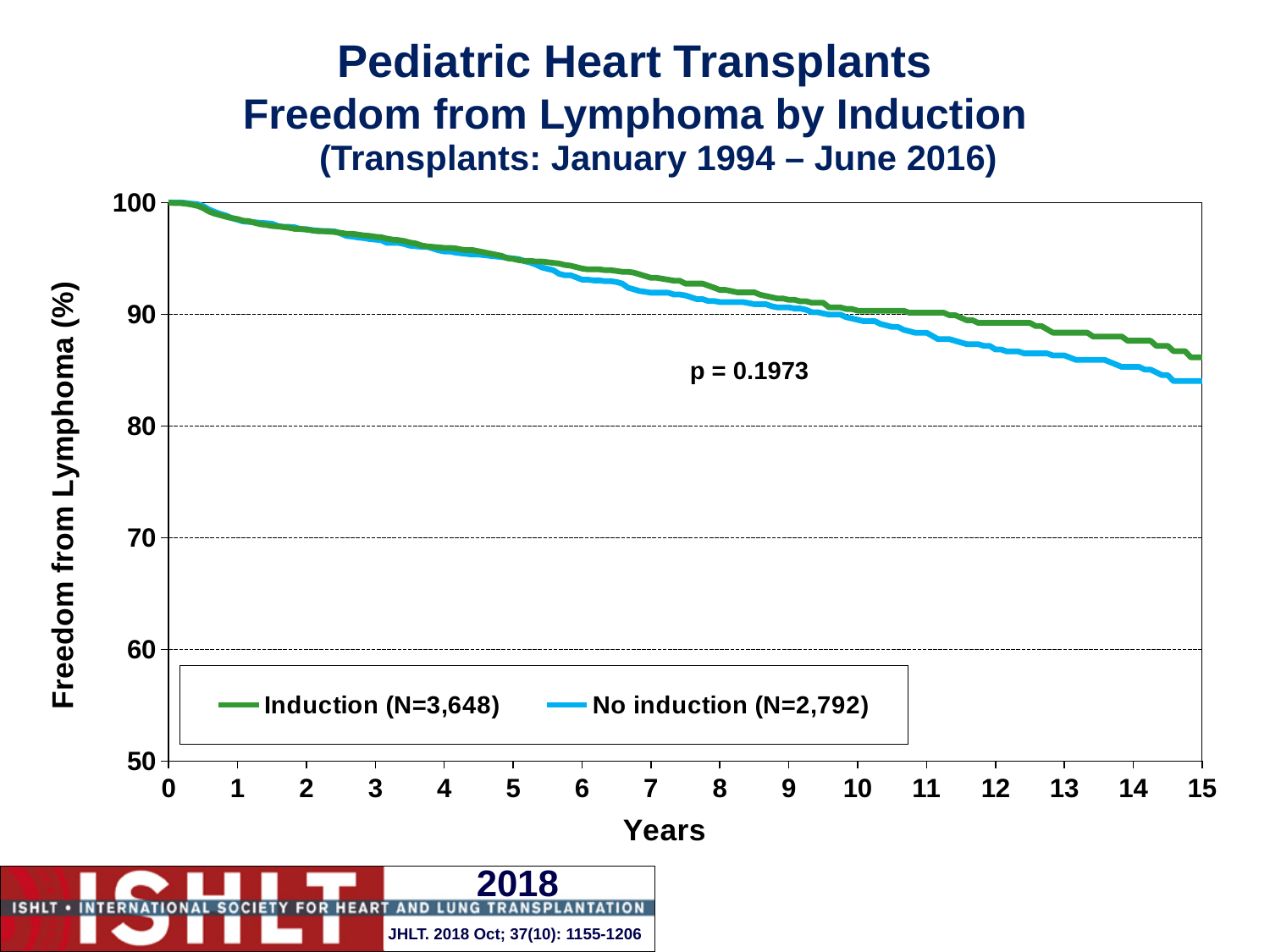
How many series does the legend list? 2 At 15 years, which series has the higher freedom from lymphoma: Induction or No induction? Induction What kind of chart is shown on the slide? Line chart Is the value for the No induction series at 15 years greater or less than 80? greater Is the value for the Induction series at 2 years greater or less than 90? greater Do the values for the No induction series rise or fall along the x axis? Fall At 12 years, which series has the lower freedom from lymphoma: Induction or No induction? No induction Is the value for the No induction series at 5 years greater or less than 90? greater What is the N for the Induction series shown in the legend? N=3,648 Do the values for the Induction series rise or fall as the years increase? Fall What p-value is printed on the chart? p = 0.1973